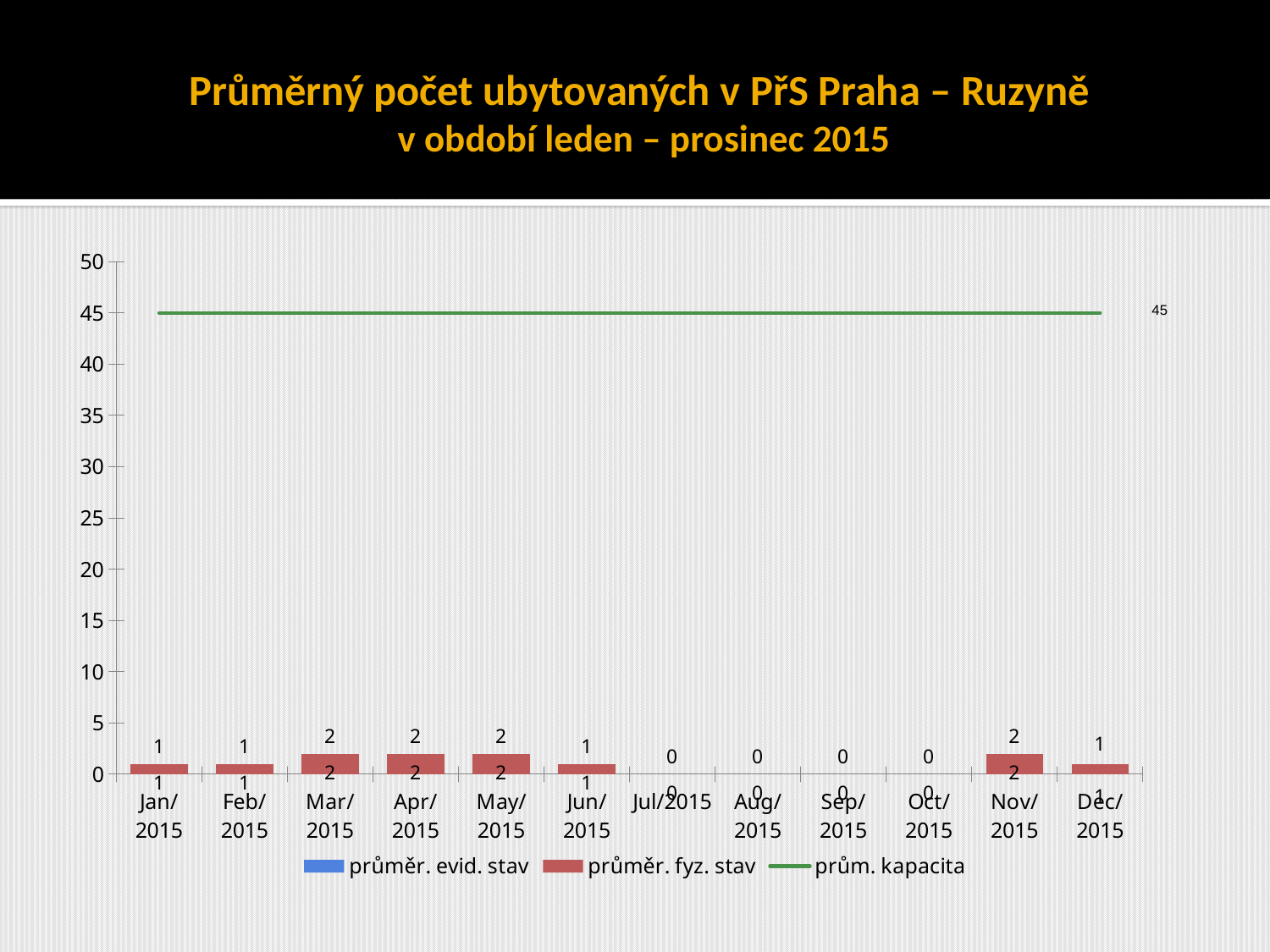
Is the prům. kapacita line greater or less than 40? greater What colour is the prům. kapacita line? green How many series does the legend list? 3 What is the value of průměr. fyz. stav for Aug/2015? 0 Which is larger, průměr. fyz. stav for Apr/2015 or for Dec/2015? Apr/2015 What is the title of the chart? Průměrný počet ubytovaných v PřS Praha – Ruzyně v období leden – prosinec 2015 What is the value of průměr. fyz. stav for Jun/2015? 1 What kind of chart is used for the průměr. fyz. stav series? bar chart What is the difference between prům. kapacita (45) and průměr. fyz. stav for Nov/2015? 43 What is the value of průměr. fyz. stav for Mar/2015? 2 What value does the prům. kapacita line show? 45 How many months are shown on the x axis? 12